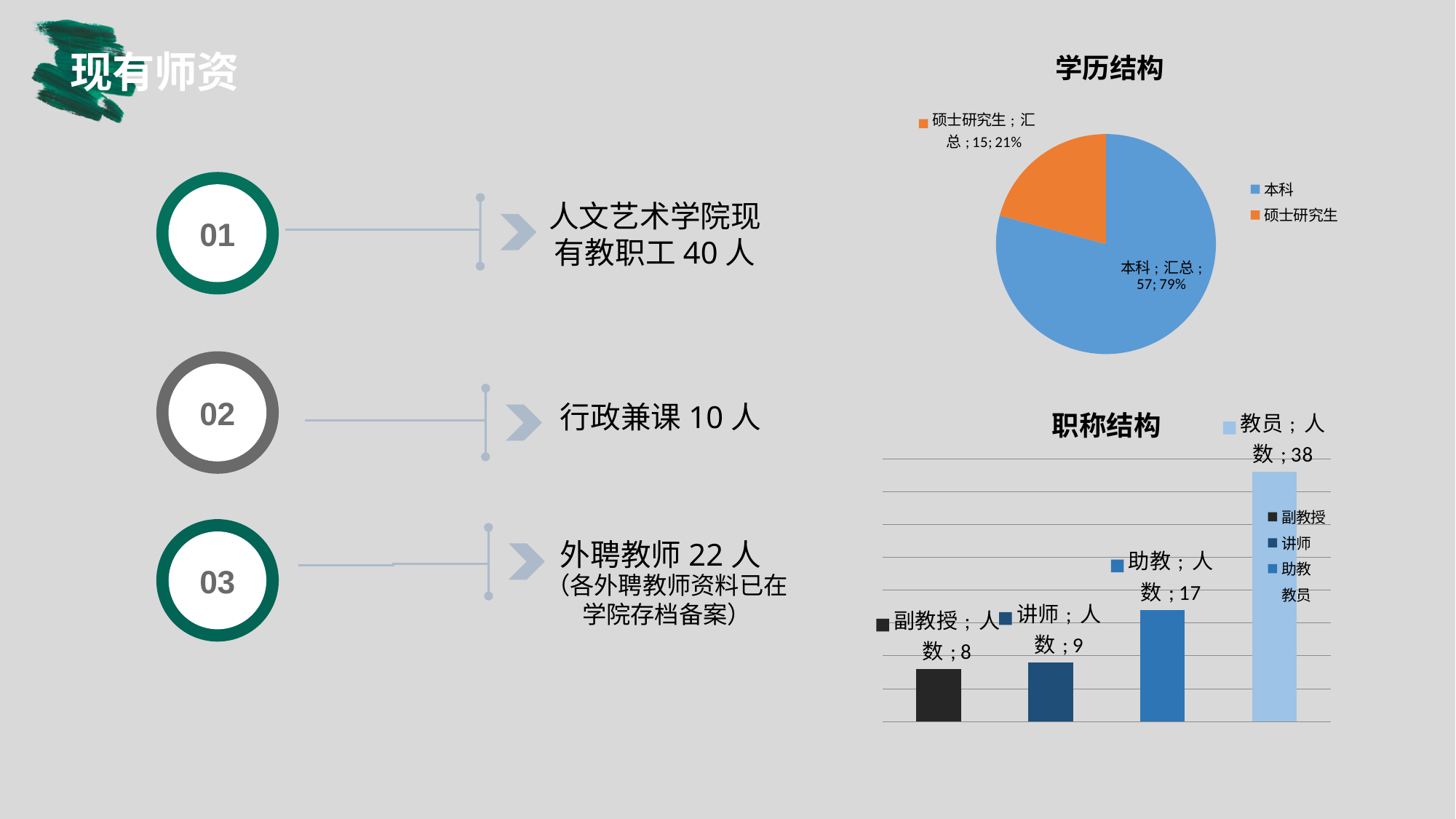
In the 职称结构 chart, what is the difference between the 教员 value and the 助教 value? 21 In the 学历结构 chart, what is the difference between the 本科 value and the 硕士研究生 value? 42 In the 职称结构 chart, which category has the highest value? 教员 What kind of chart is the 学历结构 chart? pie chart In the 职称结构 chart, which category has the lowest value? 副教授 In the 职称结构 chart, how many categories are plotted? 4 In the 学历结构 chart, what share of the pie does 硕士研究生 represent? 21% In the 学历结构 chart, what is the value for 本科? 57 In the 职称结构 chart, what is the value for 教员? 38 In the 职称结构 chart, what is the value for 助教? 17 What kind of chart is the 职称结构 chart? bar chart In the 学历结构 chart, what share of the pie does 本科 represent? 79%